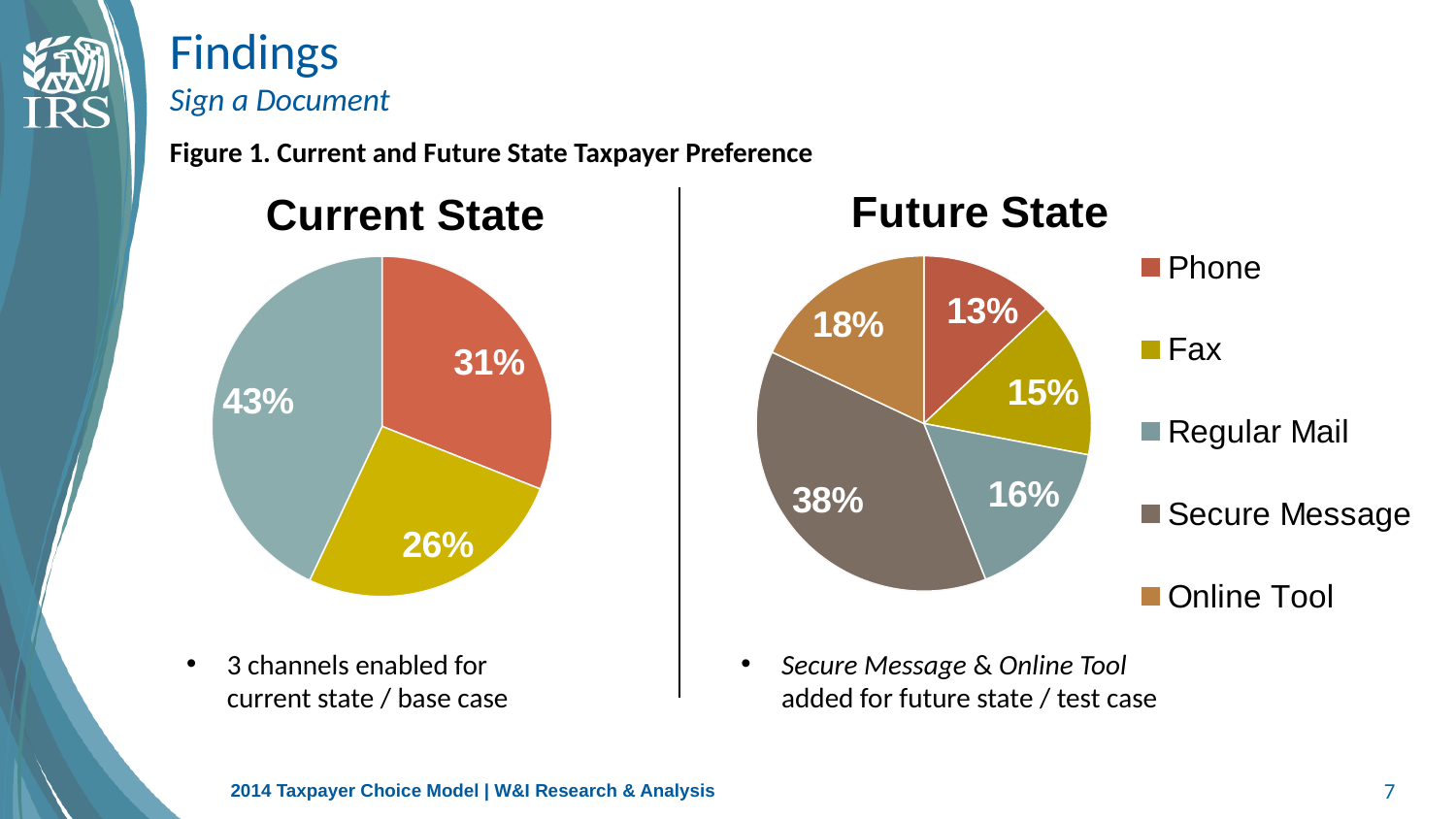
In the Current State pie chart, what is the difference between the Regular Mail share and the Fax share? 17% How many slices does the Future State pie chart have? 5 What type of chart is used for the Current State and Future State figures? Pie chart How many slices does the Current State pie chart have? 3 In the Future State pie chart, which channel has the smallest share? Phone In the Future State pie chart, what share is Secure Message? 38% In the Current State pie chart, what share is Phone? 31% In the Future State pie chart, which channel has the largest share? Secure Message In the Future State pie chart, what share is Online Tool? 18% In the Current State pie chart, which channel has the smallest share? Fax In the Future State pie chart, which is larger: the Fax share or the Regular Mail share? Regular Mail In the Current State pie chart, what share is Regular Mail? 43%